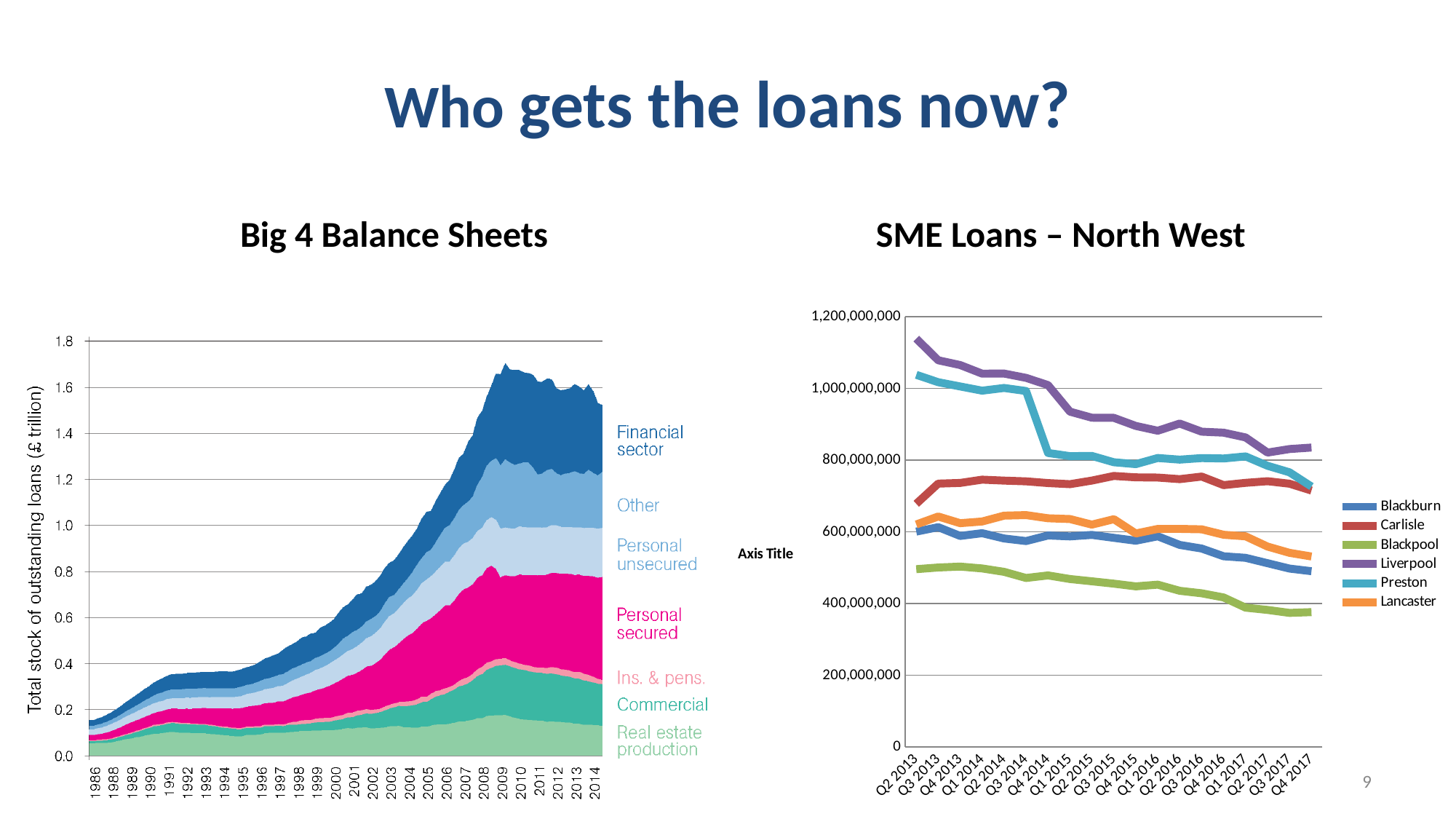
In the SME Loans – North West chart, is the value for Liverpool at Q2 2013 greater or less than 1,000,000,000? greater In the SME Loans – North West chart, does the Liverpool series rise or fall from Q2 2013 to Q4 2017? Fall How many quarters are shown on the x axis of the SME Loans – North West chart? 19 In the SME Loans – North West chart, is the value for Carlisle at Q4 2017 greater or less than 800,000,000? less In the SME Loans – North West chart, which series has the highest value at Q2 2013? Liverpool What kind of chart is the SME Loans – North West chart? Line chart In the SME Loans – North West chart, is the value for Blackpool at Q4 2017 greater or less than 400,000,000? less In the SME Loans – North West chart, which series has the lowest value at Q4 2017? Blackpool What kind of chart is the Big 4 Balance Sheets chart? Stacked area chart In the SME Loans – North West chart, which is larger at Q2 2013: Preston or Carlisle? Preston How many series does the legend of the SME Loans – North West chart list? 6